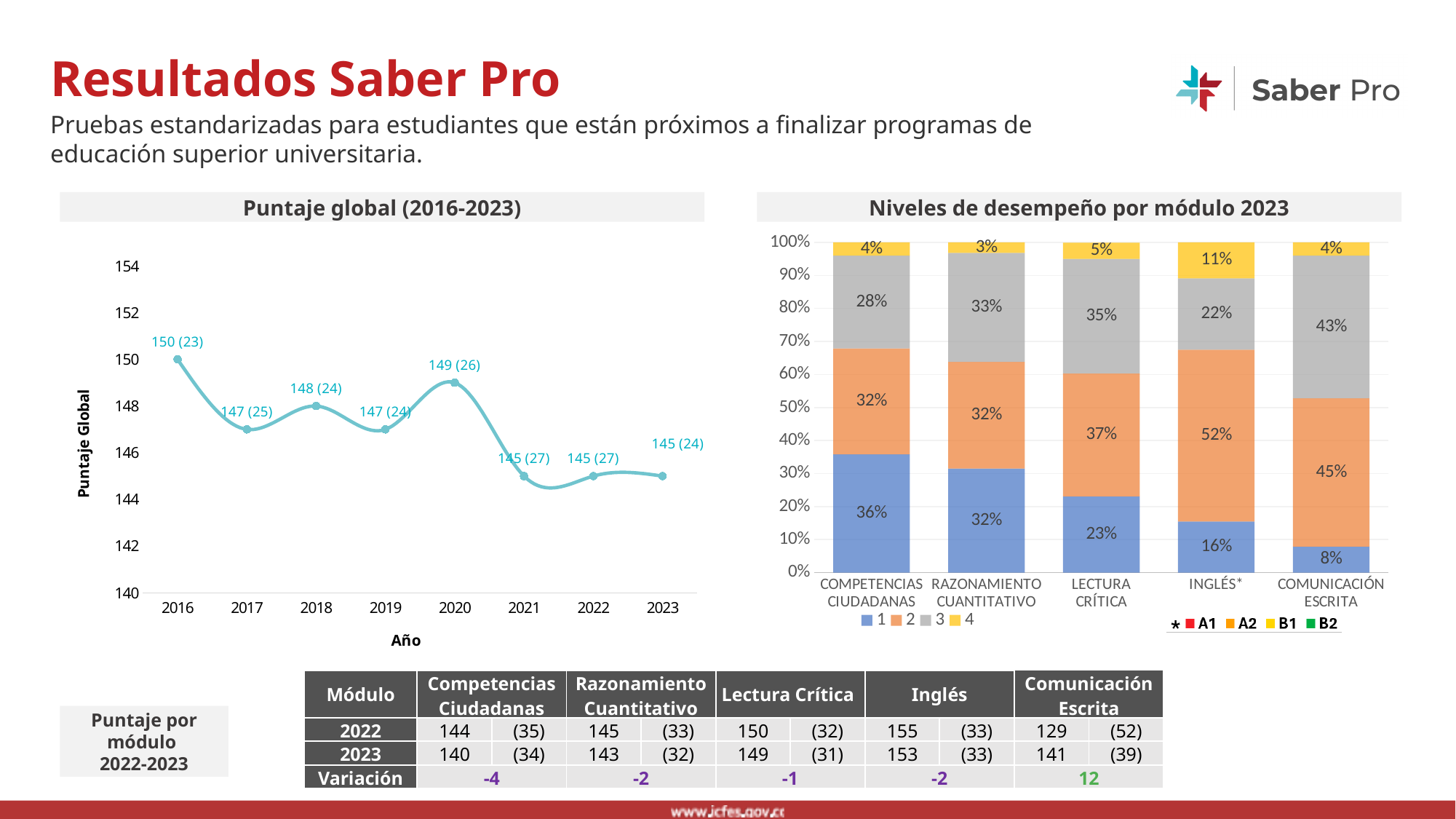
In the 'Niveles de desempeño por módulo 2023' chart, what percentage of students are at level 1 in Lectura Crítica? 23% In the 'Puntaje global (2016-2023)' chart, what is the data label shown for 2020? 149 (26) In the 'Puntaje global (2016-2023)' chart, which year has the highest global score? 2016 In the 'Niveles de desempeño por módulo 2023' chart, how many series does the legend list? 4 In the 'Puntaje global (2016-2023)' chart, what kind of chart is shown? Line chart In the 'Puntaje global (2016-2023)' chart, how many years are plotted on the x axis? 8 In the 'Puntaje global (2016-2023)' chart, what is the data label shown for 2016? 150 (23) In the 'Niveles de desempeño por módulo 2023' chart, which module has the lowest percentage at level 1? Comunicación Escrita In the 'Niveles de desempeño por módulo 2023' chart, what percentage is shown for level 4 in Inglés*? 11% In the 'Puntaje global (2016-2023)' chart, what is the difference between the global score in 2016 and in 2023? 5 In the 'Niveles de desempeño por módulo 2023' chart, which is larger: the level 2 share for Inglés* or for Comunicación Escrita? Inglés* In the 'Niveles de desempeño por módulo 2023' chart, what kind of chart is shown? Stacked bar chart